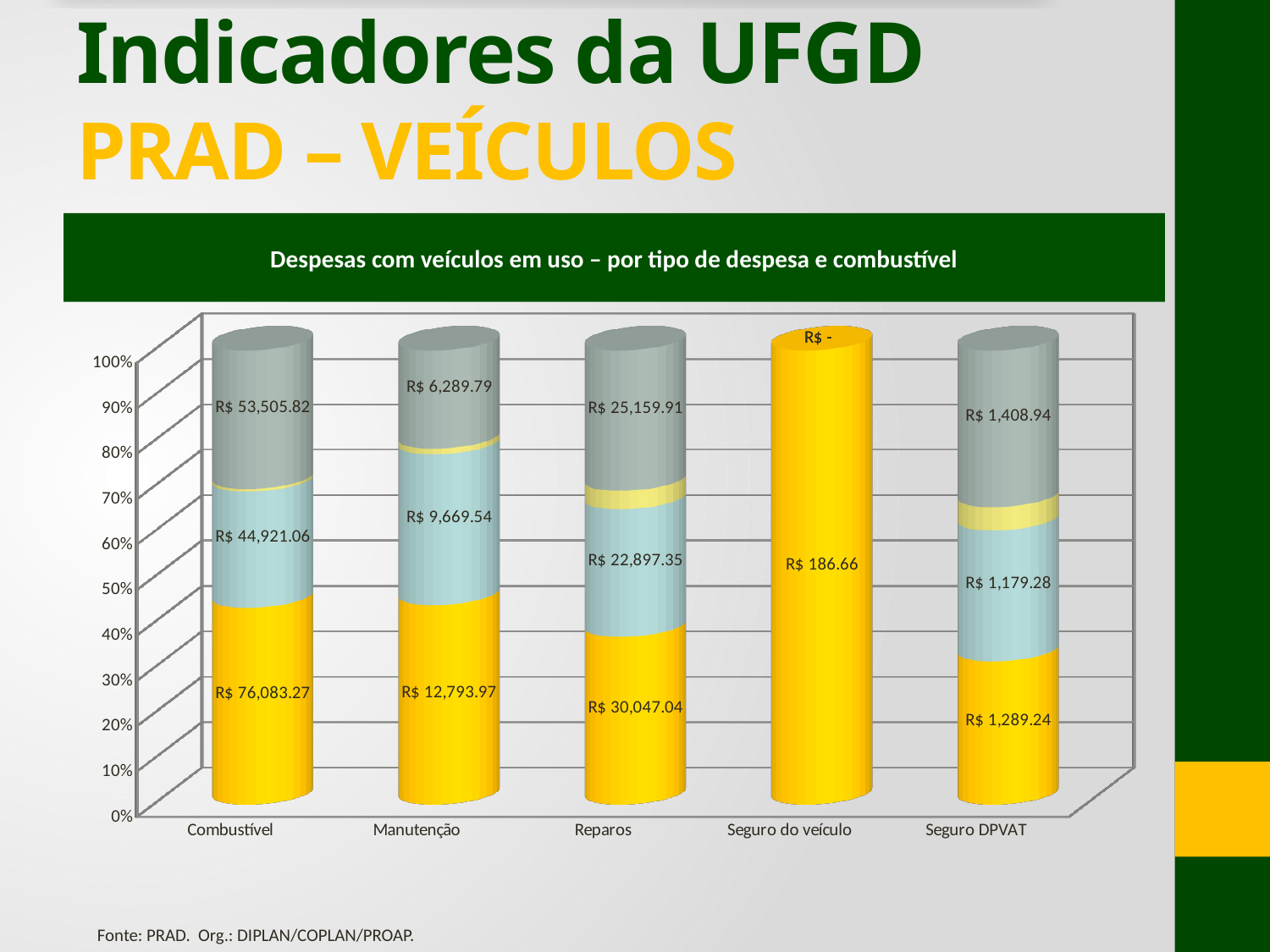
What is the value printed on the bottom yellow segment of the Combustível bar? R$ 76,083.27 What is the value printed on the top grey segment of the Combustível bar? R$ 53,505.82 What is the difference between the bottom yellow segment values of Combustível (R$ 76,083.27) and Manutenção (R$ 12,793.97)? R$ 63,289.30 Which is larger: the top grey segment value of Reparos or the middle light blue segment value of Reparos? Top grey segment (R$ 25,159.91) What is the value printed on the top grey segment of the Seguro DPVAT bar? R$ 1,408.94 Which category has the smallest value printed on its bottom yellow segment? Seguro do veículo How many categories are shown on the x axis of the chart? 5 Which category has the largest value printed on its bottom yellow segment? Combustível What is the value printed on the middle light blue segment of the Manutenção bar? R$ 9,669.54 What is the value printed on the bottom yellow segment of the Reparos bar? R$ 30,047.04 What kind of chart is shown on the slide? Stacked bar chart What value is printed on the Seguro do veículo bar? R$ 186.66